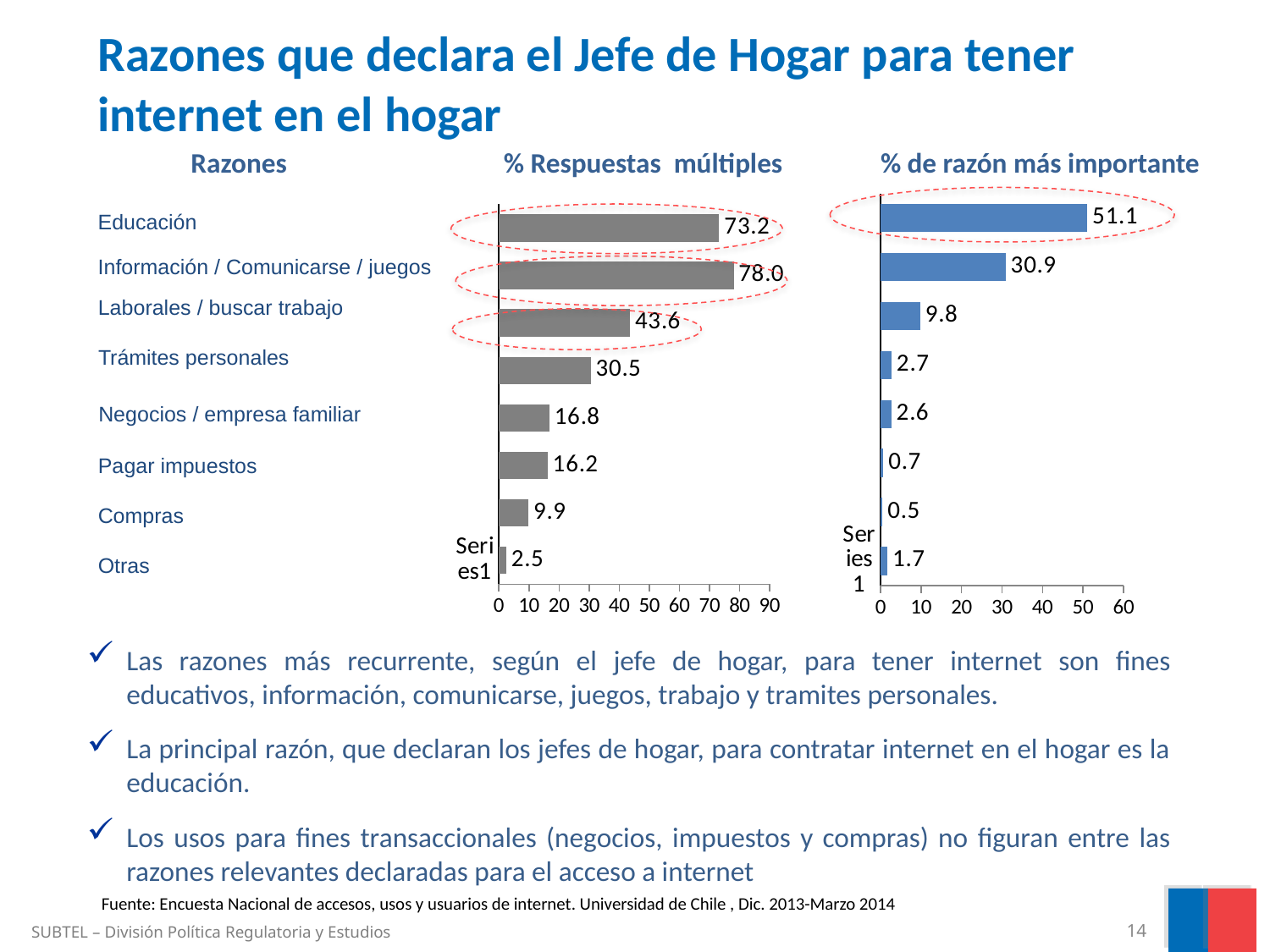
In the '% Respuestas múltiples' chart, which category has the highest value? Información / Comunicarse / juegos In the '% de razón más importante' chart, what is the value for Educación? 51.1 In the '% de razón más importante' chart, is the value for Laborales / buscar trabajo greater or less than 20? less In the '% de razón más importante' chart, what is the difference between the values for Educación and Información / Comunicarse / juegos? 20.2 In the '% Respuestas múltiples' chart, what is the value for Educación? 73.2 In the '% de razón más importante' chart, which category has the lowest value? Compras What kind of chart is the '% de razón más importante' chart? bar chart What colour are the bars in the '% de razón más importante' chart? blue In the '% Respuestas múltiples' chart, which is larger: the value for Laborales / buscar trabajo or the value for Trámites personales? Laborales / buscar trabajo In the '% Respuestas múltiples' chart, what is the difference between the values for Información / Comunicarse / juegos and Educación? 4.8 How many categories are shown in the '% Respuestas múltiples' chart? 8 In the '% Respuestas múltiples' chart, what is the value for Otras? 2.5